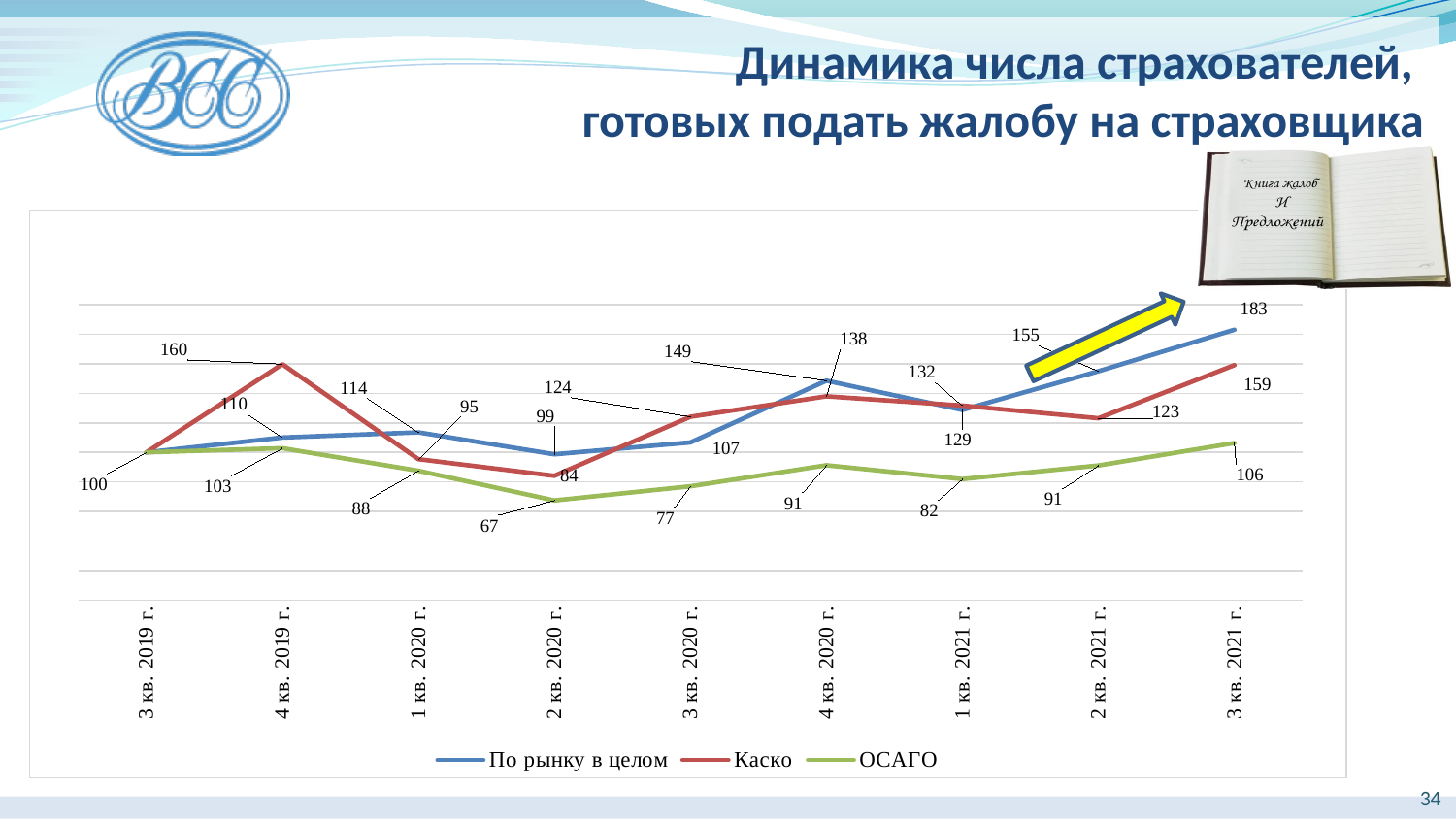
What is the value for Каско in 4 кв. 2019 г.? 160 In which quarter does the ОСАГО series reach its lowest value? 2 кв. 2020 г. Does the По рынку в целом series rise or fall from 1 кв. 2021 г. to 3 кв. 2021 г.? rise Which is larger in 3 кв. 2021 г.: По рынку в целом or ОСАГО? По рынку в целом What is the value for ОСАГО in 2 кв. 2020 г.? 67 How many quarters are plotted along the x axis? 9 How many series does the legend list? 3 What is the difference between По рынку в целом and Каско in 3 кв. 2021 г.? 24 Which series is drawn in green in the legend? ОСАГО In which quarter does the Каско series reach its highest value? 4 кв. 2019 г. What is the value for По рынку в целом in 3 кв. 2021 г.? 183 What kind of chart is shown on the slide? line chart